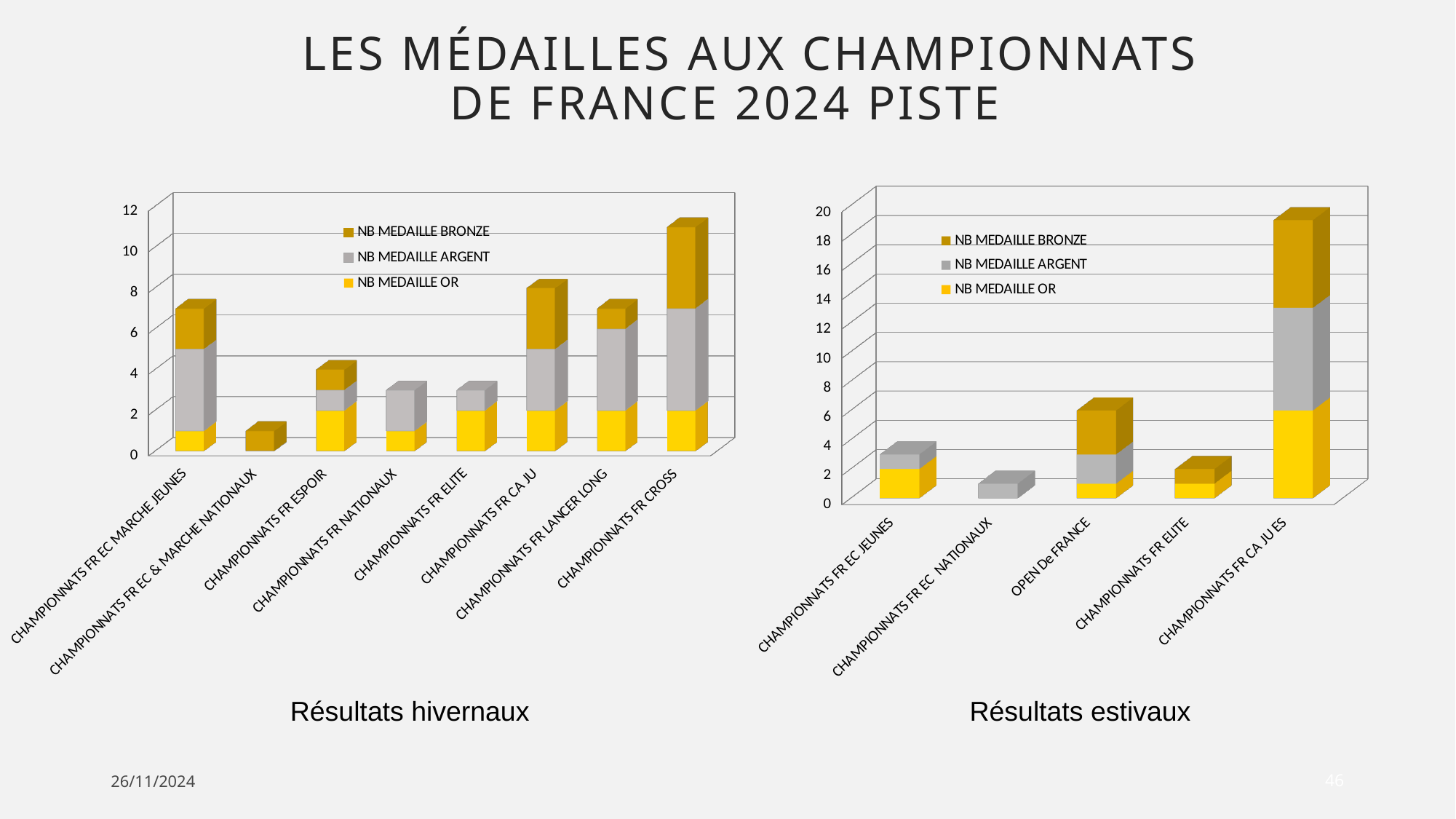
In the Résultats estivaux chart, which category has the shortest stacked bar? CHAMPIONNATS FR EC NATIONAUX How many categories are shown on the x axis of the Résultats hivernaux chart? 8 In the Résultats estivaux chart, which category has the tallest stacked bar? CHAMPIONNATS FR CA JU ES What type of chart is used for the Résultats hivernaux chart on the left? Stacked bar chart In the Résultats hivernaux chart, which category has the tallest stacked bar? CHAMPIONNATS FR CROSS In the Résultats hivernaux chart, is the total stacked bar for CHAMPIONNATS FR CROSS greater or less than 8? greater How many categories are shown on the x axis of the Résultats estivaux chart? 5 In the Résultats hivernaux chart, which category has the shortest stacked bar? CHAMPIONNATS FR EC & MARCHE NATIONAUX Which legend entry is shown in yellow in both charts? NB MEDAILLE OR In the Résultats hivernaux chart, which has the taller stacked bar: CHAMPIONNATS FR CA JU or CHAMPIONNATS FR ESPOIR? CHAMPIONNATS FR CA JU How many series does the legend of the Résultats estivaux chart list? 3 In the Résultats estivaux chart, is the total stacked bar for OPEN De FRANCE greater or less than 8? less